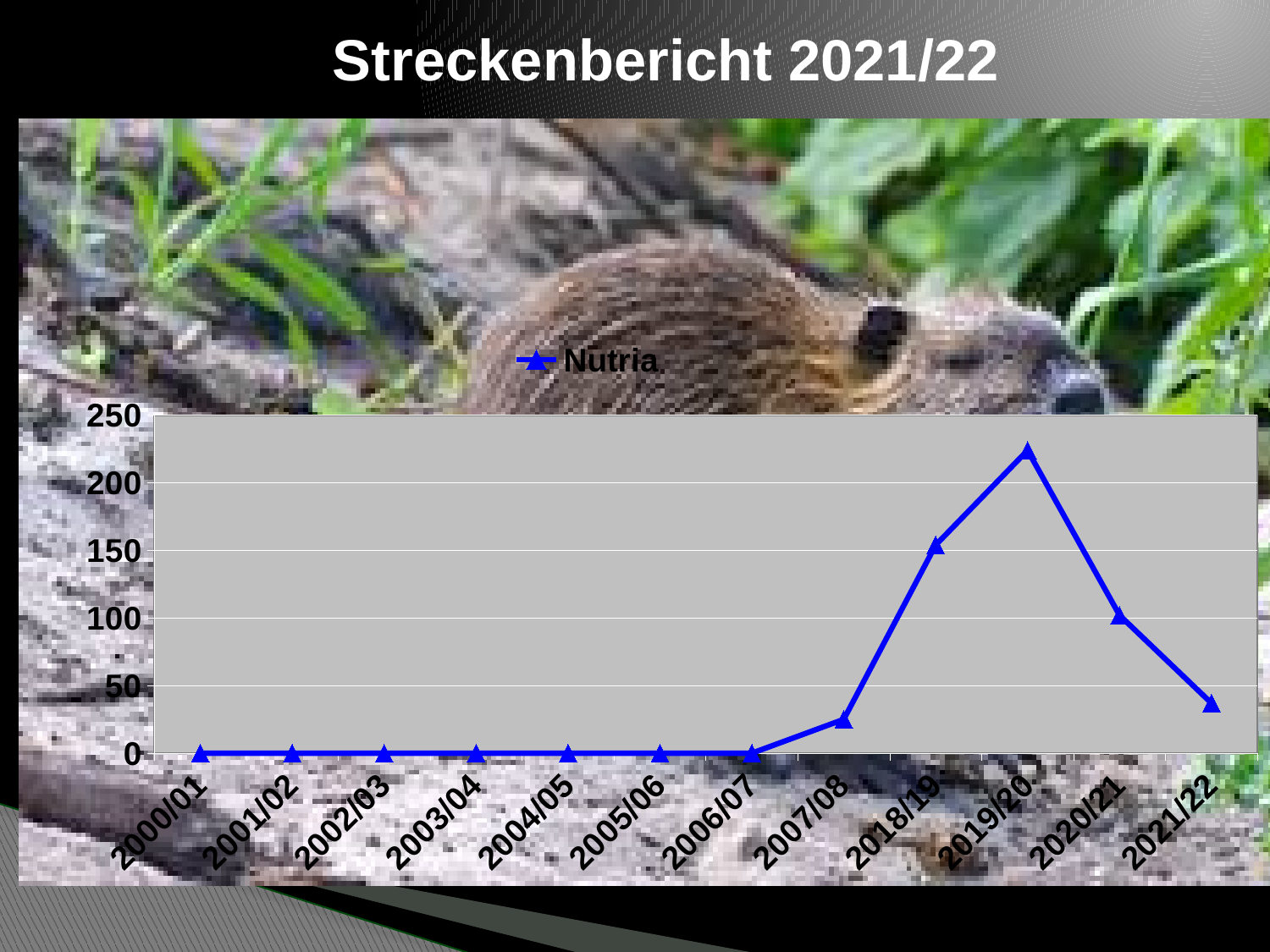
Which season has the larger Nutria value, 2018/19 or 2020/21? 2018/19 How many series does the legend list? 1 What is the Nutria value for 2000/01? 0 Do the Nutria values rise or fall from 2019/20 to 2021/22? fall What kind of chart is shown on the slide? line chart How many hunting seasons (categories) are shown on the x axis? 12 Which season has the highest Nutria value? 2019/20 Is the Nutria value for 2019/20 greater or less than 200? greater What is the Nutria value for 2003/04? 0 Is the Nutria value for 2018/19 greater or less than 100? greater Is the Nutria value for 2007/08 greater or less than 50? less What is the name of the series shown in the legend? Nutria